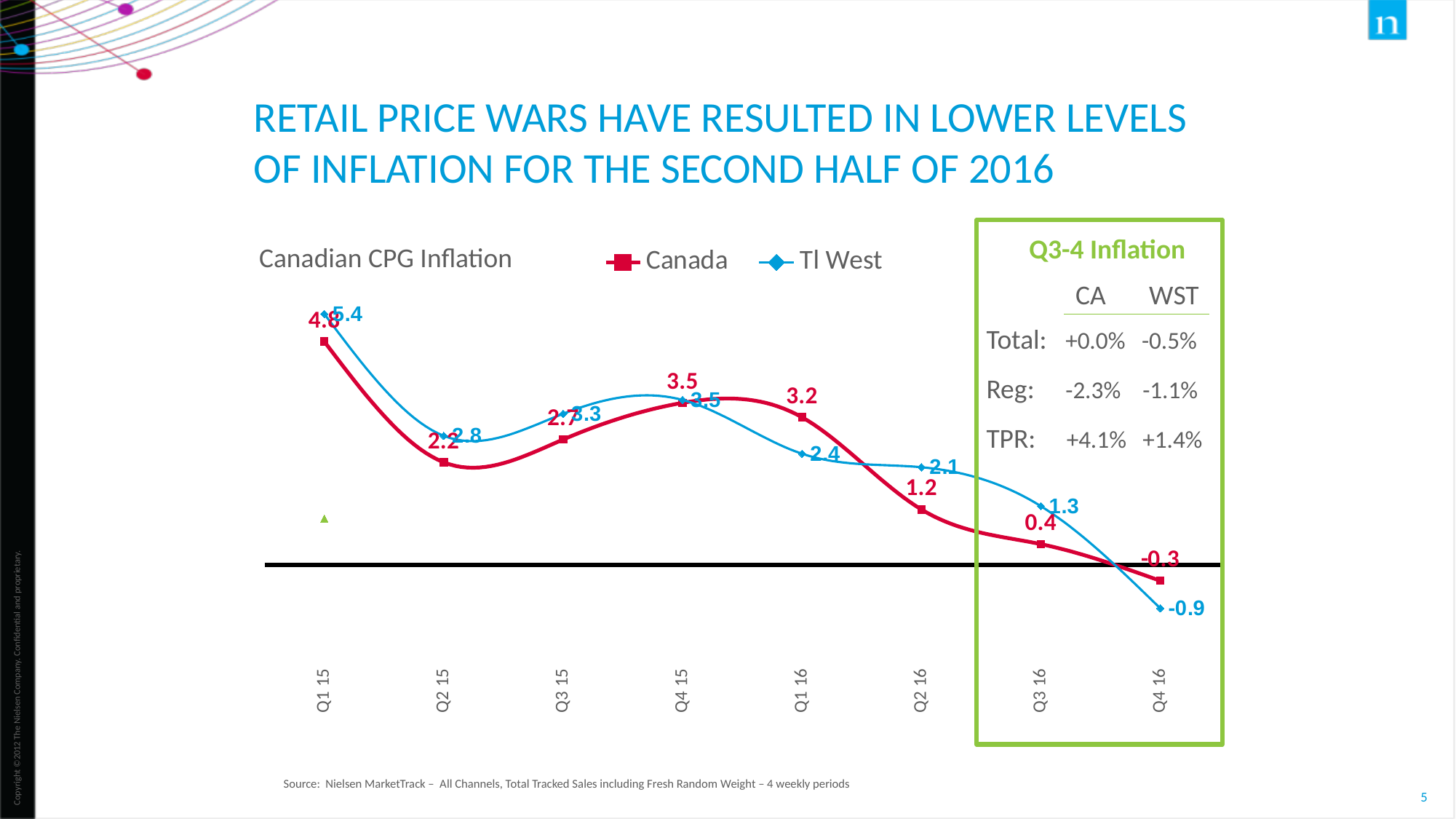
What kind of chart is the Canadian CPG Inflation chart? Line chart What is the Canada value for Q3 16 in the Canadian CPG Inflation chart? 0.4 How many quarters are shown on the x axis of the Canadian CPG Inflation chart? 8 What is the Tl West value for Q1 16 in the Canadian CPG Inflation chart? 2.4 In which quarter is the Tl West series lowest in the Canadian CPG Inflation chart? Q4 16 How many series does the legend of the Canadian CPG Inflation chart list? 2 What is the Canada value for Q2 16 in the Canadian CPG Inflation chart? 1.2 Which series has the higher value in Q3 16 in the Canadian CPG Inflation chart, Canada or Tl West? Tl West What is the difference between the Tl West and Canada values for Q2 16 in the Canadian CPG Inflation chart? 0.9 What is the Tl West value for Q4 16 in the Canadian CPG Inflation chart? -0.9 In which quarter is the Canada series highest in the Canadian CPG Inflation chart? Q1 15 Does the Canada series rise or fall from Q1 16 to Q4 16 in the Canadian CPG Inflation chart? Fall